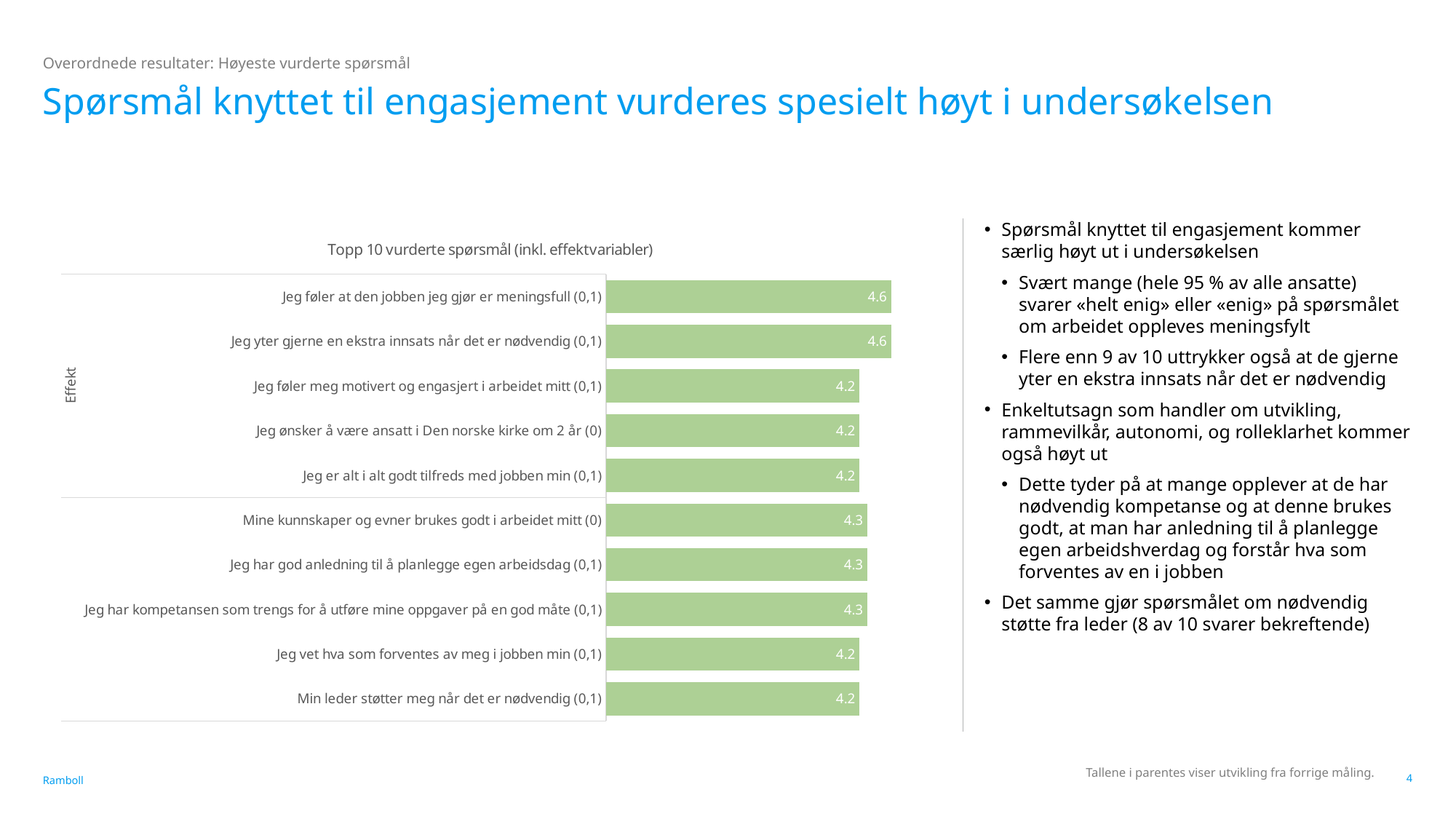
What colour are the bars in the chart? Green What is the title of the chart? Topp 10 vurderte spørsmål (inkl. effektvariabler) What is the value for "Mine kunnskaper og evner brukes godt i arbeidet mitt (0)"? 4.3 What is the difference between the value for "Jeg yter gjerne en ekstra innsats når det er nødvendig (0,1)" and the value for "Jeg vet hva som forventes av meg i jobben min (0,1)"? 0.4 What kind of chart is shown on the slide? Bar chart Which has the larger value: "Jeg har god anledning til å planlegge egen arbeidsdag (0,1)" or "Jeg er alt i alt godt tilfreds med jobben min (0,1)"? Jeg har god anledning til å planlegge egen arbeidsdag (0,1) How many questions (bars) are shown in the chart? 10 What is the highest value shown in the chart? 4.6 What is the value for "Jeg føler at den jobben jeg gjør er meningsfull (0,1)"? 4.6 What is the value for "Jeg ønsker å være ansatt i Den norske kirke om 2 år (0)"? 4.2 What is the value for "Min leder støtter meg når det er nødvendig (0,1)"? 4.2 What is the lowest value shown in the chart? 4.2